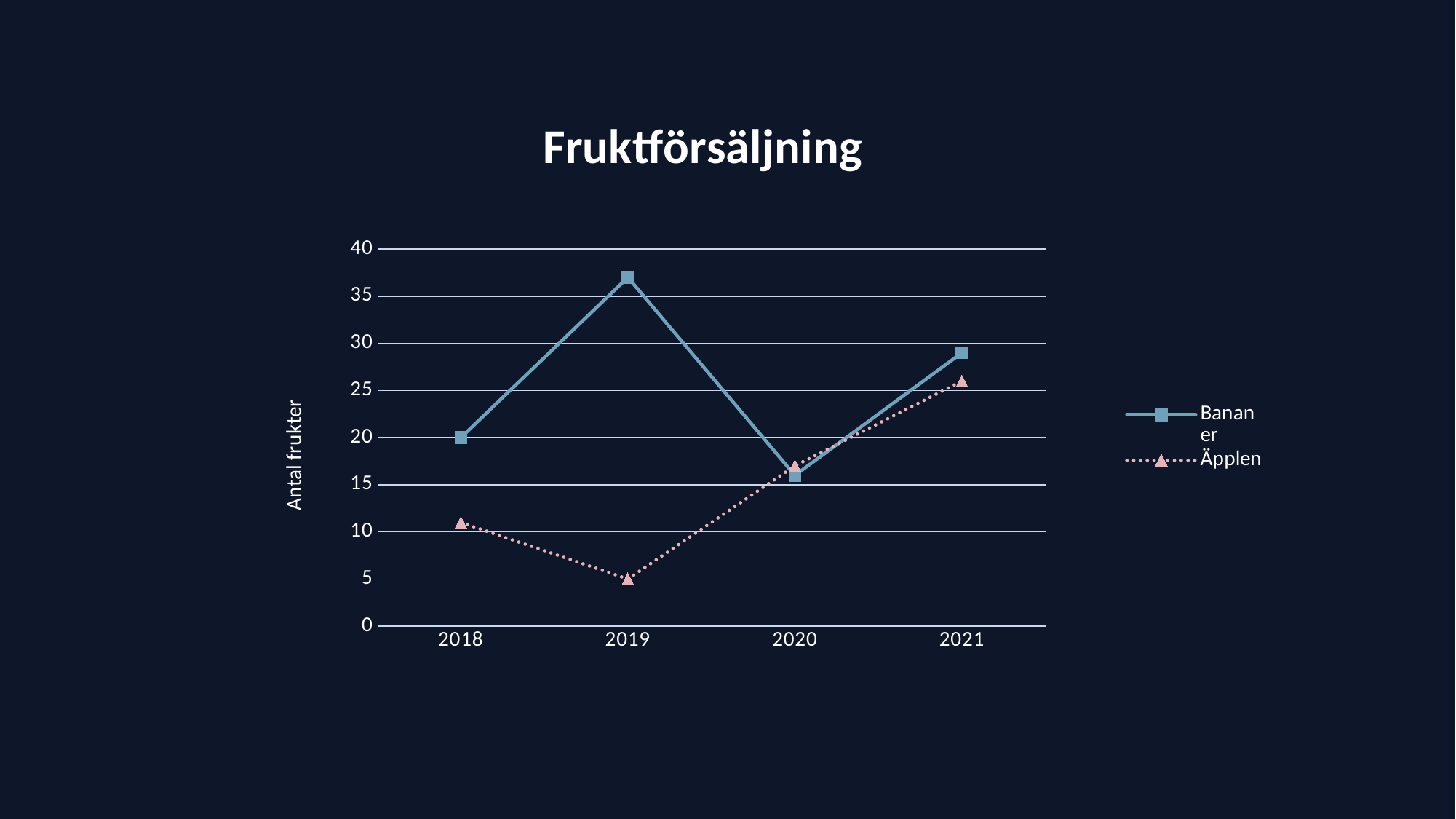
What is the value for Bananer in 2018? 20 How many series does the legend list? 2 What kind of chart is shown on the slide? line chart How many years are plotted along the x axis? 4 What is the title of the chart? Fruktförsäljning In which year is the value for Äpplen lowest? 2019 What is the value for Äpplen in 2019? 5 Is the value for Bananer in 2020 greater or less than 20? less Which series has the larger value in 2019, Bananer or Äpplen? Bananer Is the value for Bananer in 2019 greater or less than 35? greater Do the values for Äpplen rise or fall from 2019 to 2021? rise In which year is the value for Bananer highest? 2019